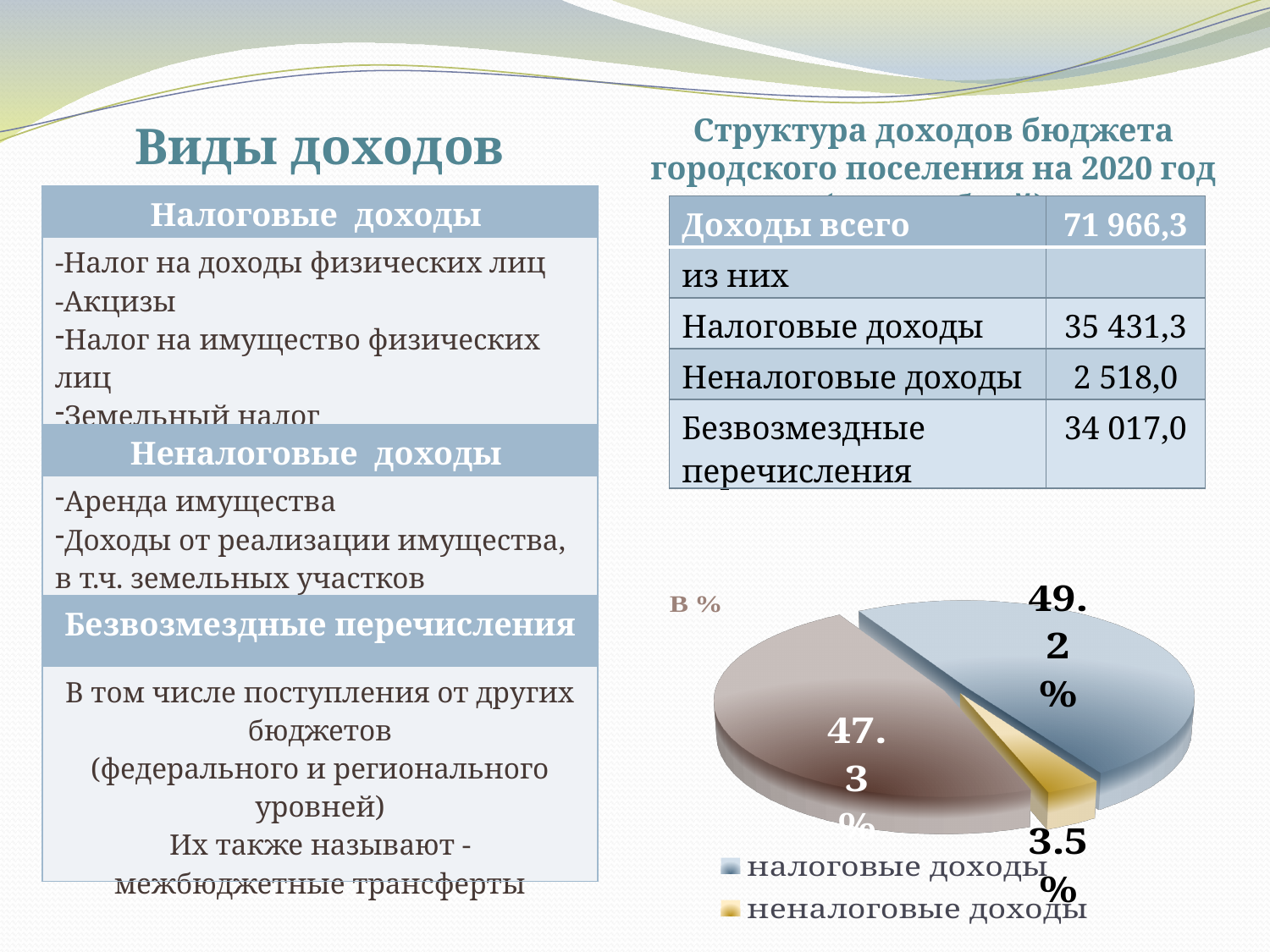
What is the difference in percentage points between the налоговые доходы slice (49.2%) and the неналоговые доходы slice (3.5%)? 45.7 Which is larger in the pie chart: налоговые доходы or неналоговые доходы? налоговые доходы Which slice of the pie chart is the smallest? неналоговые доходы What share of the pie chart is labelled for неналоговые доходы? 3.5% What kind of chart is shown on the slide? pie chart What share of the pie chart is labelled for налоговые доходы? 49.2% What colour is the налоговые доходы slice in the pie chart? blue Which slice of the pie chart is the largest? налоговые доходы What unit label is shown next to the pie chart? в % What is the difference in percentage points between the 49.2% slice and the 47.3% slice? 1.9 How many slices does the pie chart have? 3